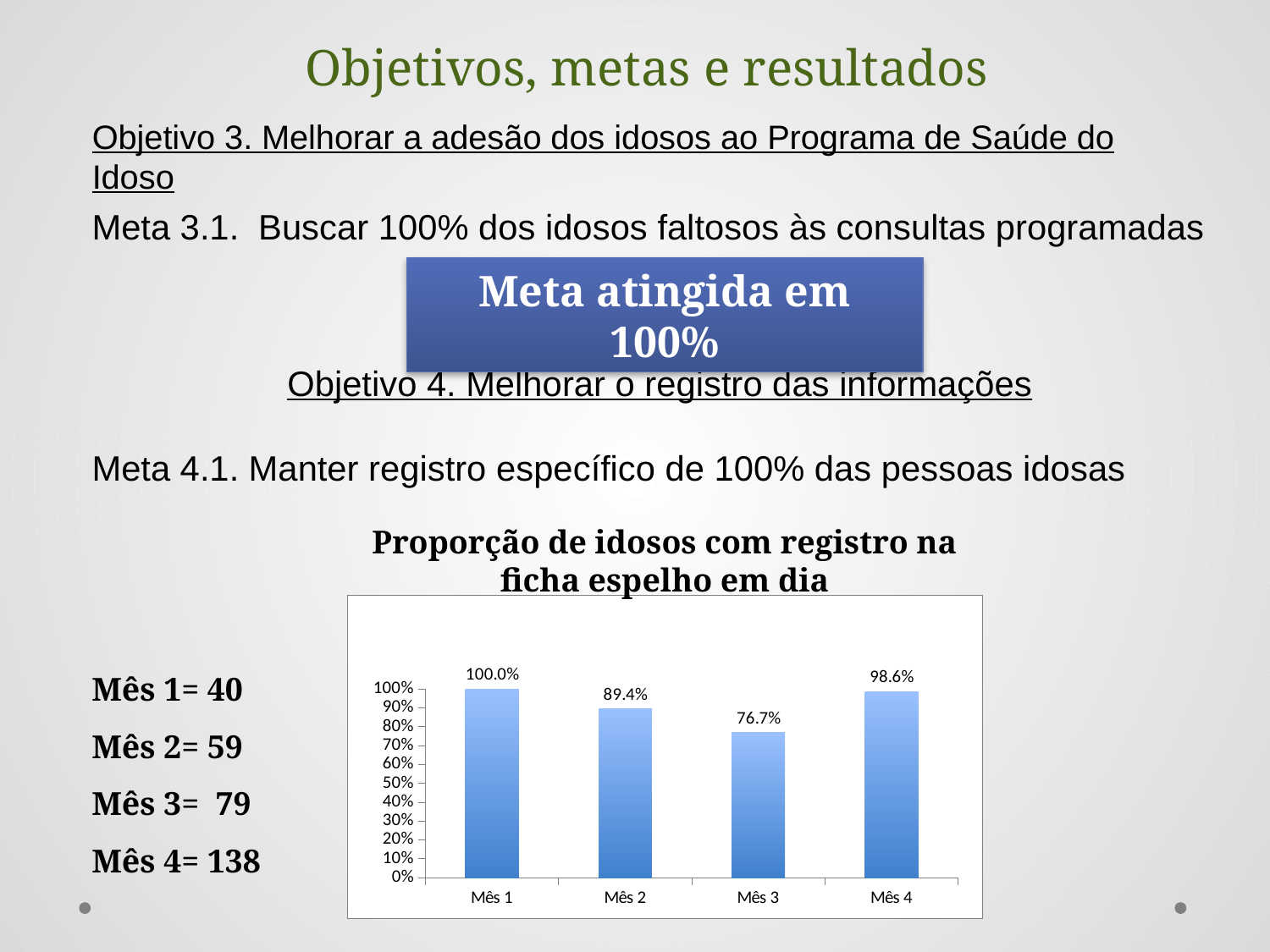
What is the value for Mês 3 in the chart? 76.7% Which month has the lowest proportion in the chart? Mês 3 Which is larger, the value for Mês 2 or the value for Mês 4? Mês 4 What is the title of the chart? Proporção de idosos com registro na ficha espelho em dia Is the value for Mês 3 greater or less than 80%? less What kind of chart is shown on the slide? bar chart What is the difference between the values for Mês 1 and Mês 3? 23.3% Which month has the highest proportion in the chart? Mês 1 What is the value for Mês 2 in the chart? 89.4% What is the difference between the values for Mês 4 and Mês 2? 9.2% How many months are shown on the x axis of the chart? 4 What is the value for Mês 4 in the chart? 98.6%